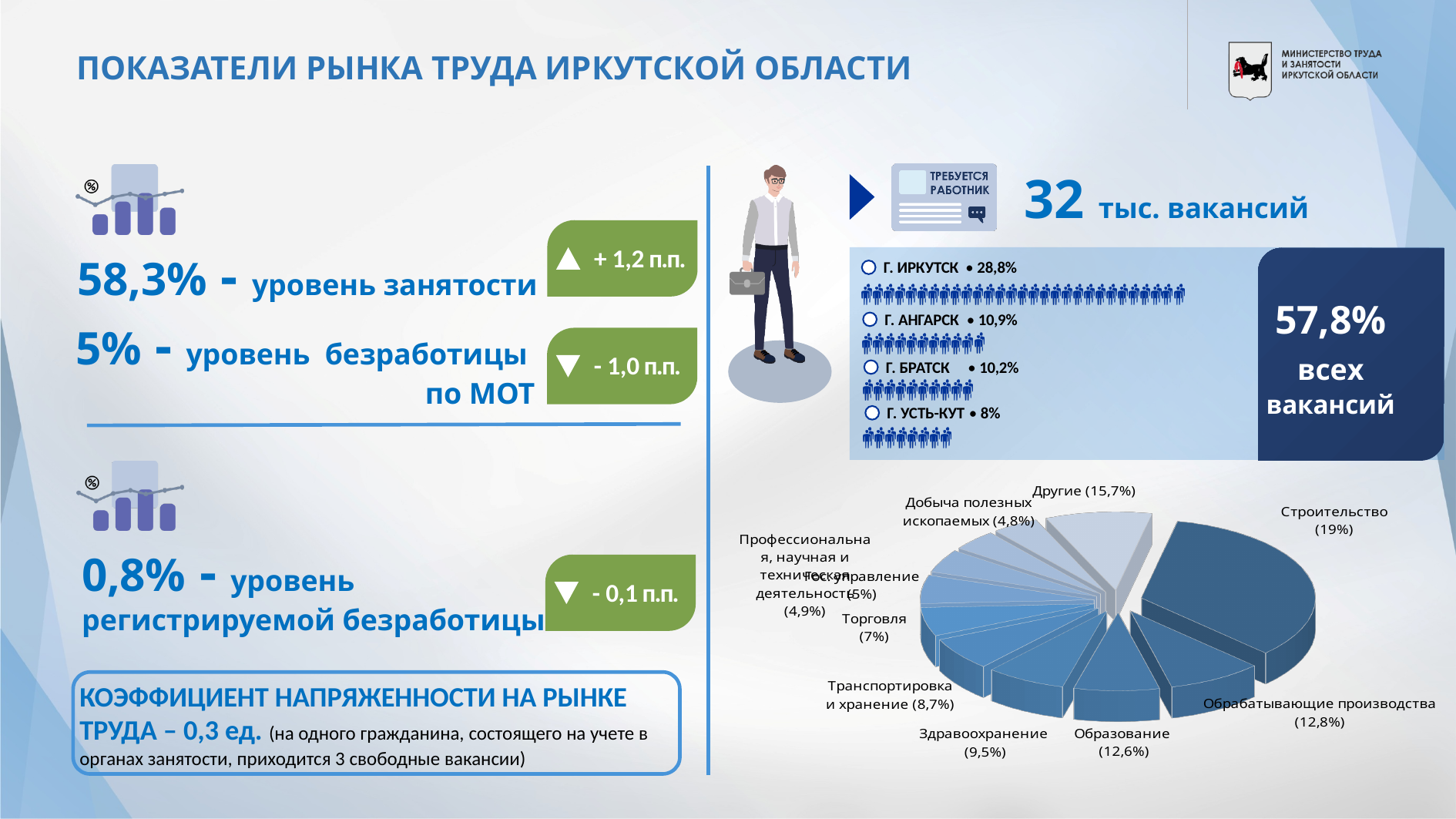
In the city pictogram chart, which city has the lowest share of vacancies? г. Усть-Кут In the pie chart, which named sector (excluding Другие) has the largest share? Строительство In the pie chart, which is larger: Образование or Здравоохранение? Образование In the pie chart, what is the difference in percentage points between Строительство and Обрабатывающие производства? 6,2 In the city pictogram chart, what share of vacancies is shown for г. Иркутск? 28,8% In the pie chart, what share is shown for Обрабатывающие производства? 12,8% In the pie chart, what share is shown for Здравоохранение? 9,5% What kind of chart is shown in the lower right of the slide? Pie chart In the pie chart, what share is shown for Строительство? 19% In the pie chart, what share is shown for Торговля? 7% In the pie chart, what share is shown for Транспортировка и хранение? 8,7%